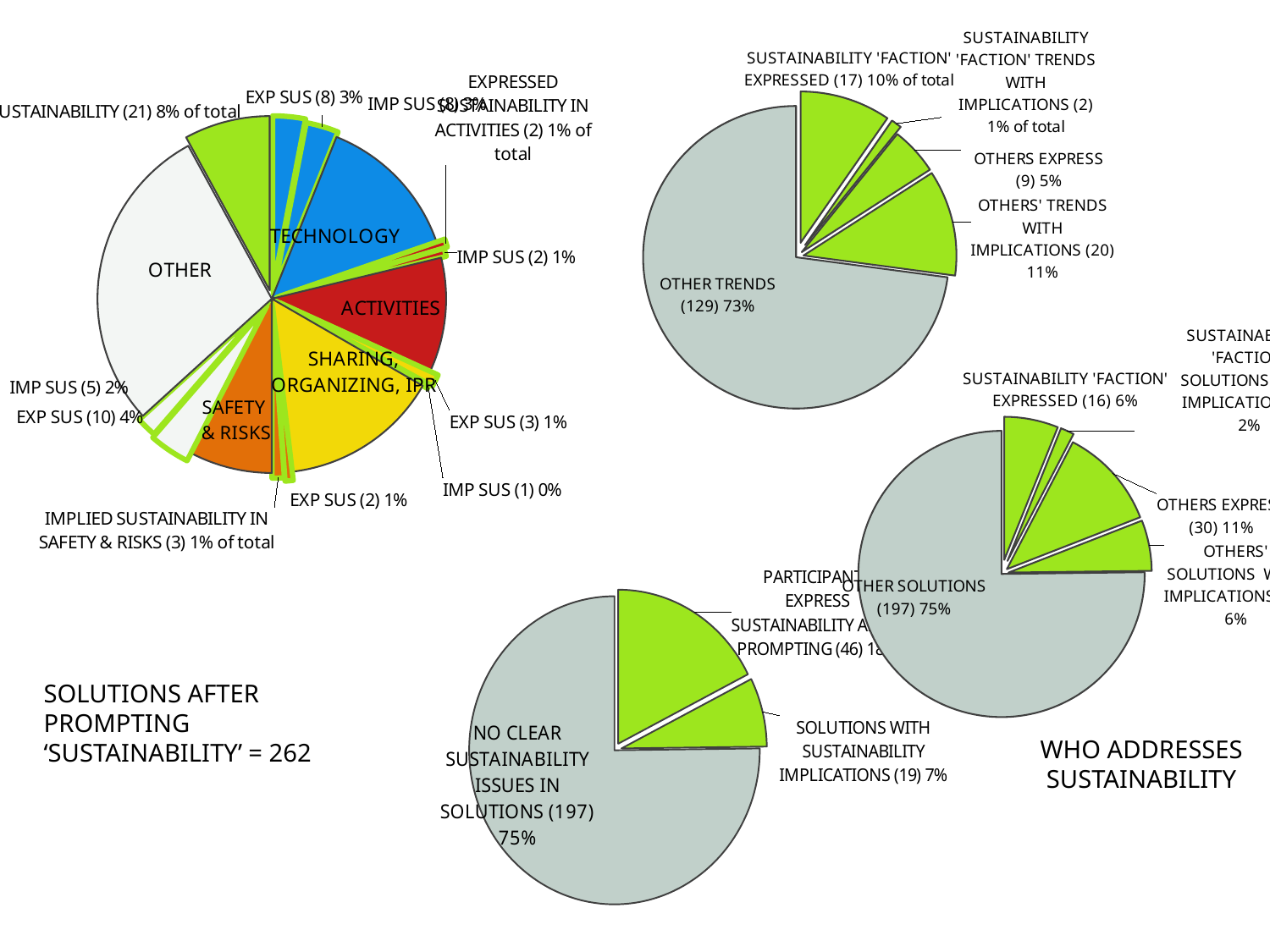
In the middle-right pie chart (who addresses sustainability, solutions), how many solutions are counted under OTHERS EXPRESS? 30 What total number of solutions is stated in the text 'SOLUTIONS AFTER PROMPTING 'SUSTAINABILITY''? 262 In the top-right pie chart (trends), what is the difference in count between OTHERS' TRENDS WITH IMPLICATIONS (20) and OTHERS EXPRESS (9)? 11 In the top-left pie chart, what percentage is labelled for the EXP SUS slice with count (10)? 4% In the top-right pie chart (trends), how many trends are counted under OTHERS' TRENDS WITH IMPLICATIONS? 20 What kind of chart is used for the bottom-centre chart on the slide? Pie chart In the bottom-centre pie chart, which slice is the largest? NO CLEAR SUSTAINABILITY ISSUES IN SOLUTIONS In the middle-right pie chart (who addresses sustainability, solutions), what percentage is labelled for OTHER SOLUTIONS? 75% In the bottom-centre pie chart (solutions after prompting 'sustainability'), what percentage is labelled for NO CLEAR SUSTAINABILITY ISSUES IN SOLUTIONS? 75% In the bottom-centre pie chart (solutions after prompting 'sustainability'), how many solutions are counted as SOLUTIONS WITH SUSTAINABILITY IMPLICATIONS? 19 In the top-right pie chart (trends), what percentage is labelled for OTHER TRENDS? 73% In the top-right pie chart (trends), which slice is the smallest? SUSTAINABILITY 'FACTION' TRENDS WITH IMPLICATIONS